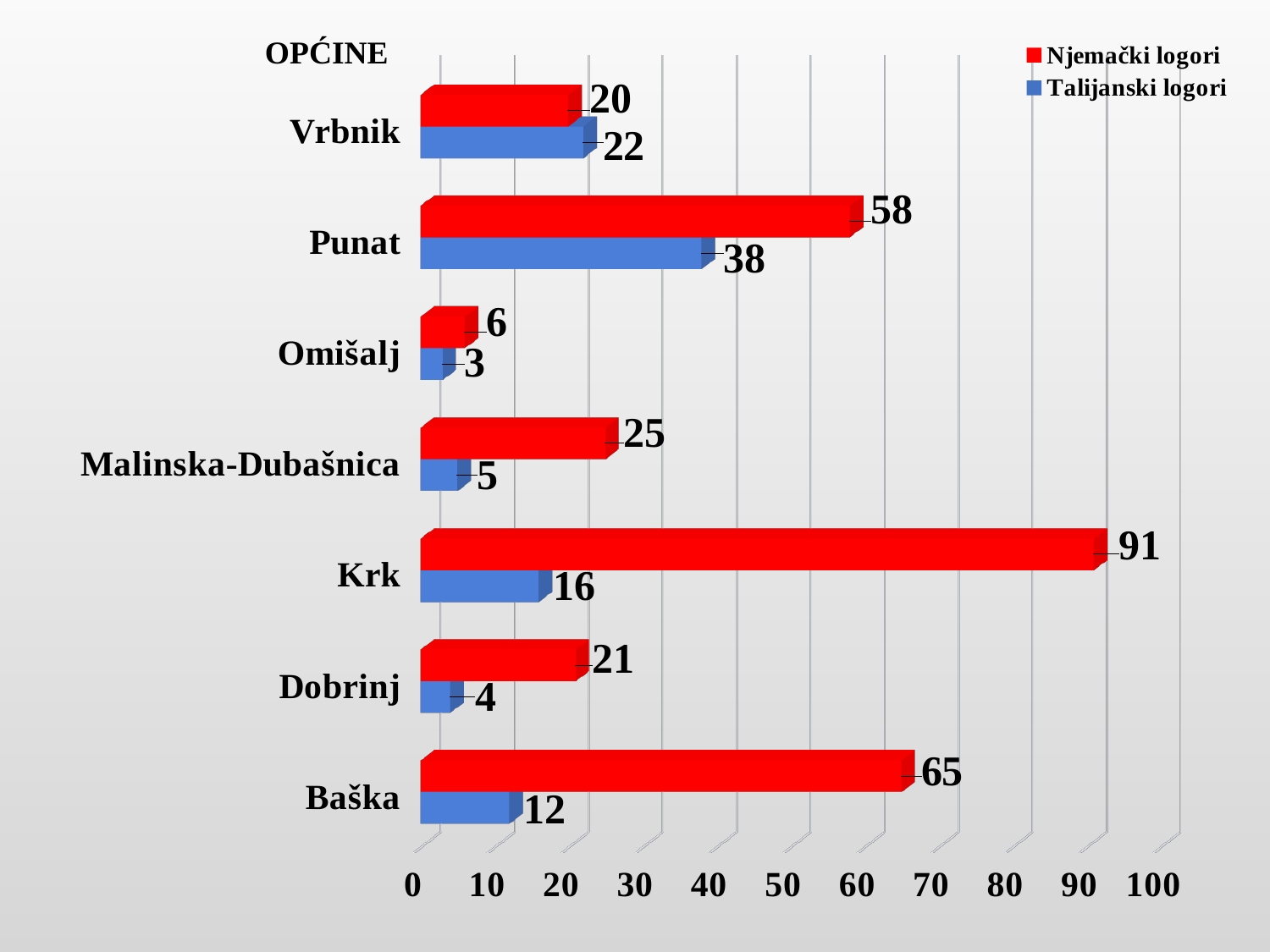
What colour represents Talijanski logori in the chart? Blue What is the difference between Njemački logori and Talijanski logori in Baška? 53 How many series does the legend list? 2 What is the label above the category axis? OPĆINE How many municipalities are shown on the chart? 7 What kind of chart is shown on the slide? Bar chart Which municipality has the lowest value for Talijanski logori? Omišalj What is the value for Talijanski logori in Punat? 38 Which is larger in Vrbnik: Njemački logori or Talijanski logori? Talijanski logori Which municipality has the highest value for Njemački logori? Krk What is the value for Talijanski logori in Vrbnik? 22 What is the value for Njemački logori in Krk? 91